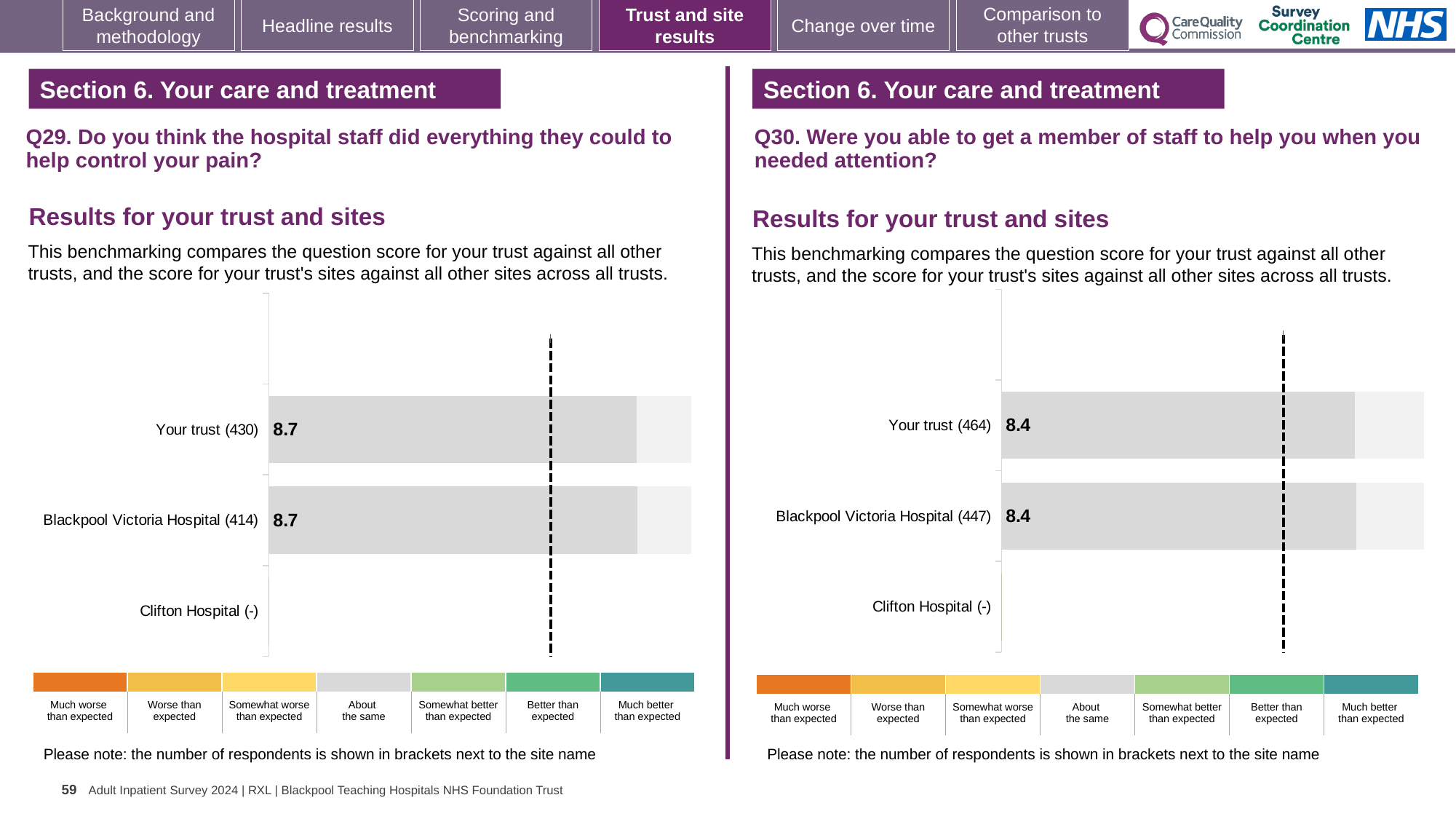
In the Q30 chart on the right, how many site/trust categories are listed on the axis? 3 In the Q29 chart on the left, how many site/trust categories are listed on the axis? 3 In the Q29 chart on the left, how many respondents are shown in brackets for Your trust? 430 In the Q30 chart on the right, what is the score for Blackpool Victoria Hospital? 8.4 In the Q30 chart on the right, what is the score for Your trust? 8.4 Is the score for Your trust in the Q30 chart on the right larger or smaller than the score for Your trust in the Q29 chart on the left? Smaller What kind of chart is the Q29 chart on the left? Bar chart In the Q29 chart on the left, what is the difference between the score for Your trust and the score for Blackpool Victoria Hospital? 0 In the Q30 chart on the right, which category has no score shown? Clifton Hospital (-) In the Q29 chart on the left, what is the score for Blackpool Victoria Hospital? 8.7 In the Q29 chart on the left, what is the score for Your trust? 8.7